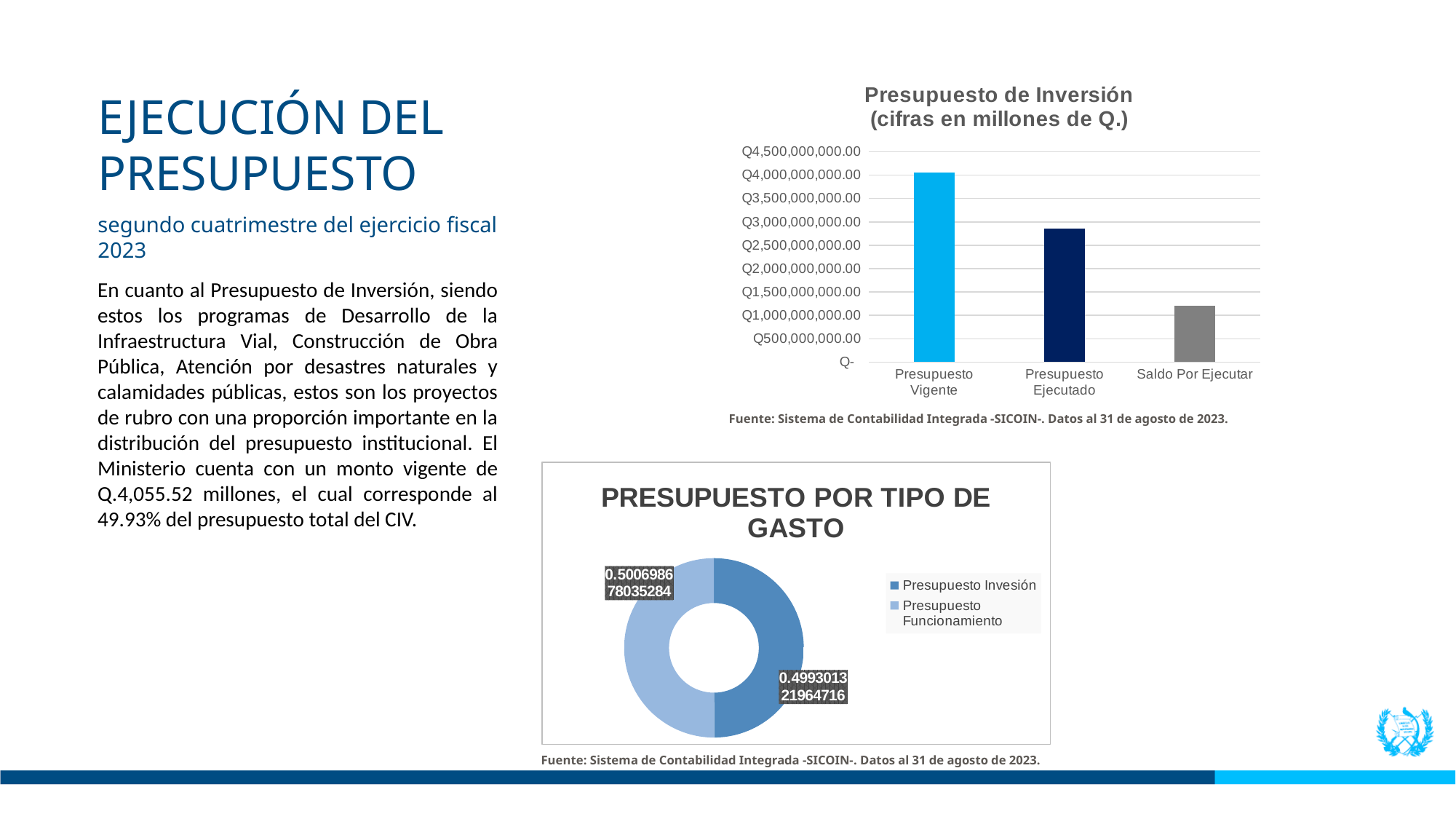
In the 'Presupuesto de Inversión' chart, which category has the lowest value? Saldo Por Ejecutar In the 'Presupuesto de Inversión' chart, which category has the highest value? Presupuesto Vigente In the 'PRESUPUESTO POR TIPO DE GASTO' chart, what value is labelled for Presupuesto Invesión? 0.499301321964716 In the 'PRESUPUESTO POR TIPO DE GASTO' chart, what value is labelled for Presupuesto Funcionamiento? 0.500698678035284 In the 'Presupuesto de Inversión' chart, what kind of chart is shown? bar chart In the 'PRESUPUESTO POR TIPO DE GASTO' chart, how many entries does the legend list? 2 In the 'Presupuesto de Inversión' chart, is the value for Presupuesto Ejecutado greater or less than Q3,000,000,000.00? less In the 'Presupuesto de Inversión' chart, how many categories are plotted? 3 In the 'Presupuesto de Inversión' chart, which is larger: Presupuesto Ejecutado or Saldo Por Ejecutar? Presupuesto Ejecutado In the 'PRESUPUESTO POR TIPO DE GASTO' chart, what kind of chart is shown? doughnut chart In the 'Presupuesto de Inversión' chart, is the value for Saldo Por Ejecutar greater or less than Q1,000,000,000.00? greater